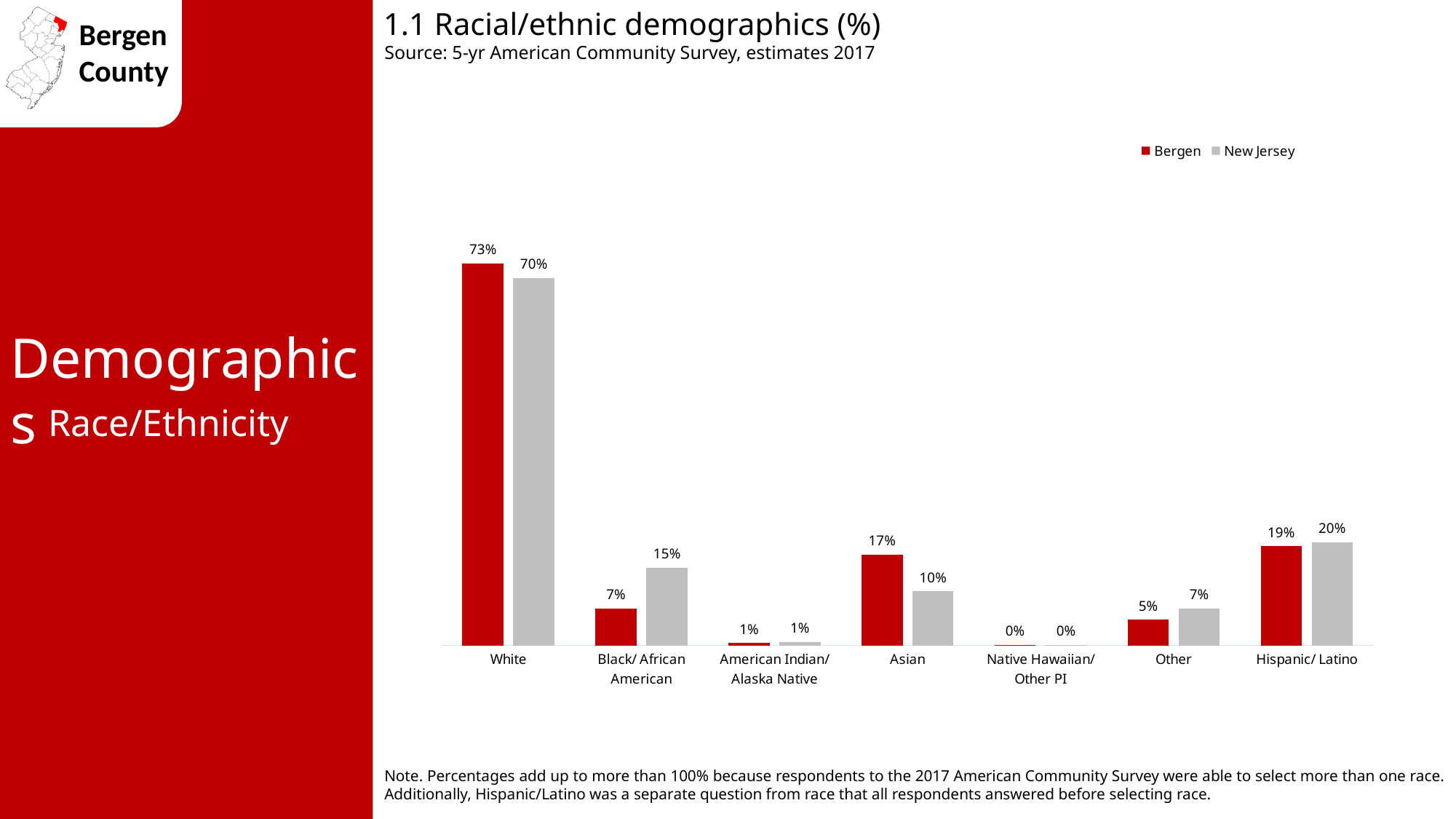
Which is larger for Other: the Bergen value or the New Jersey value? New Jersey Which category has the highest Bergen value? White What is the Bergen value for White? 73% What is the Bergen value for Asian? 17% How many categories are shown on the x axis? 7 Which category has the lowest New Jersey value? Native Hawaiian/ Other PI What is the difference between the Bergen and New Jersey values for Black/ African American? 8% What is the New Jersey value for Hispanic/ Latino? 20% What is the New Jersey value for Black/ African American? 15% What is the difference between the Bergen and New Jersey values for Asian? 7% What kind of chart is shown on the slide? Bar chart How many series does the legend list? 2